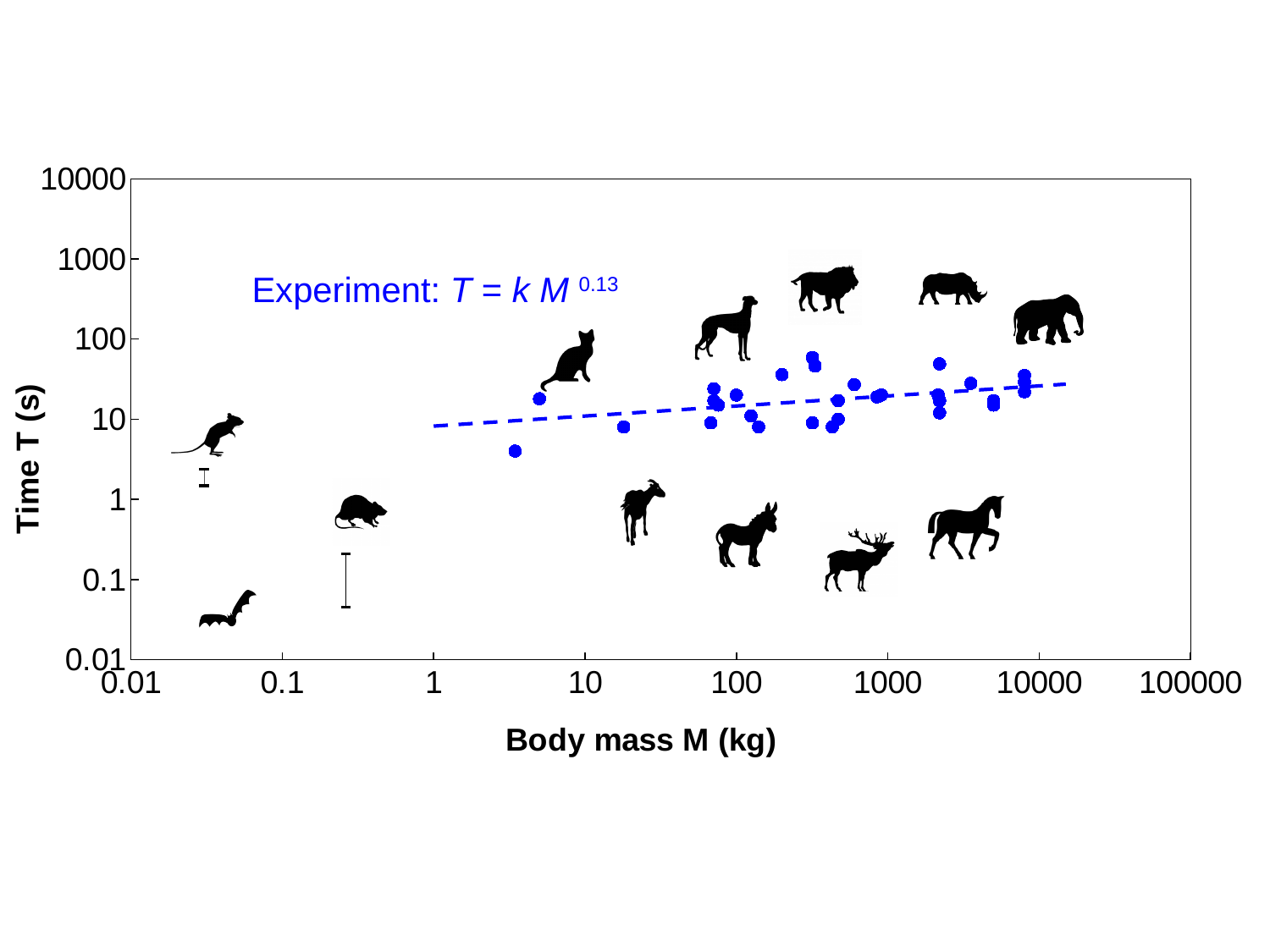
What kind of chart is shown on the slide? scatter plot Is the dashed fitted line at a body mass of 1 kg greater or less than 10 s? less Is the time value of the highest blue data point greater or less than 100 s? less Does the dashed fitted line rise or fall as body mass increases along the x axis? rise Is the time value of the highest blue data point greater or less than 10 s? greater What is the label of the x axis? Body mass M (kg) What is the smallest value shown on the y axis? 0.01 What is the label of the y axis? Time T (s) What is the largest value shown on the x axis? 100000 What exponent of M appears in the fitted relation T = k M^x written on the chart? 0.13